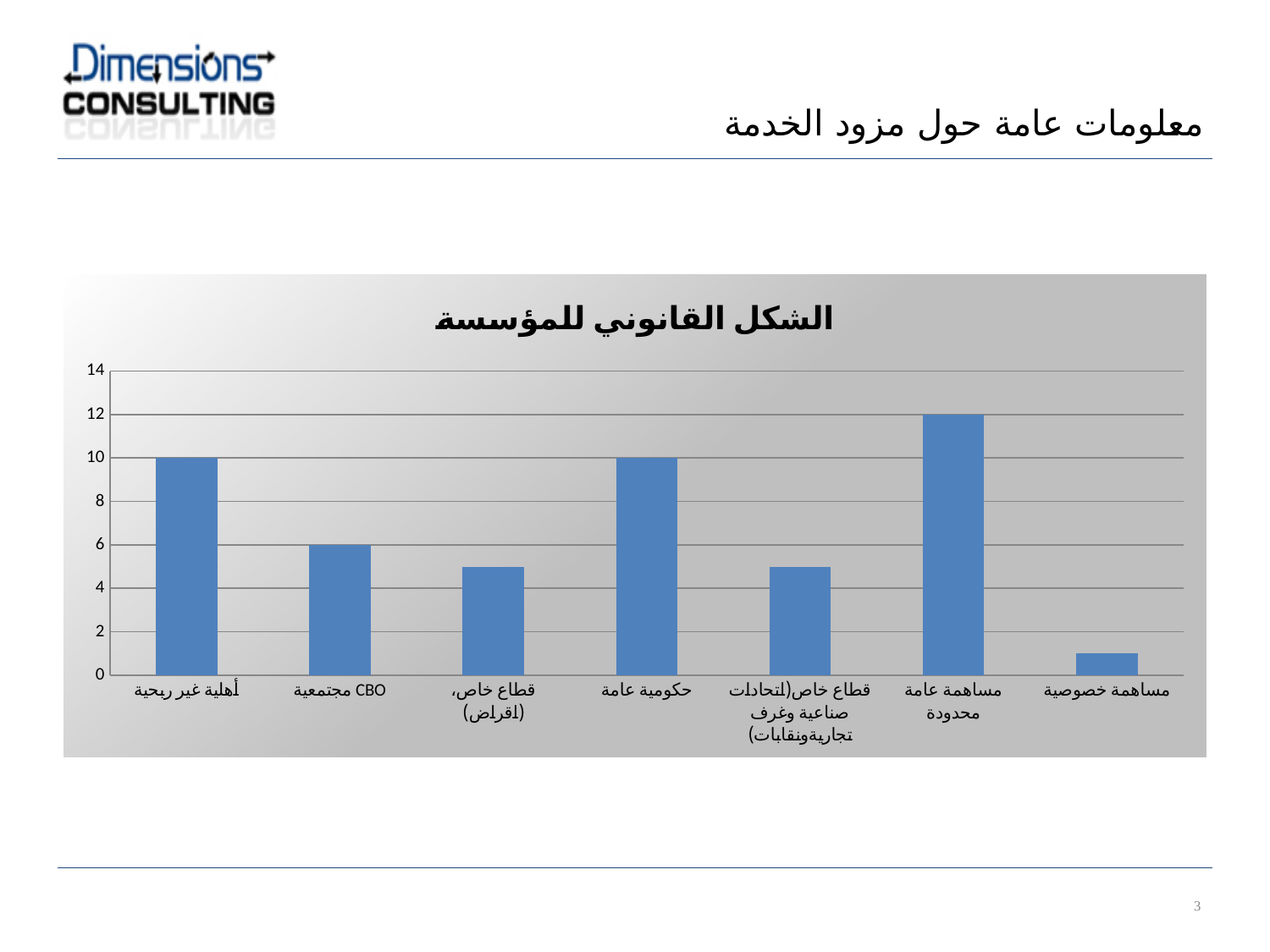
Is the value for قطاع خاص، (اقراض) greater or less than 6? less What is the value for أهلية غير ربحية? 10 What is the title of the chart? الشكل القانوني للمؤسسة What is the value for مساهمة عامة محدودة? 12 What is the difference between the values for مساهمة عامة محدودة and حكومية عامة? 2 Which category has the lowest value in the chart? مساهمة خصوصية Which category has the highest value in the chart? مساهمة عامة محدودة Which is larger, the value for أهلية غير ربحية or the value for CBO مجتمعية? أهلية غير ربحية How many categories are shown on the x axis of the chart? 7 What type of chart is shown on the slide? Bar chart What is the value for CBO مجتمعية? 6 What is the value for حكومية عامة? 10